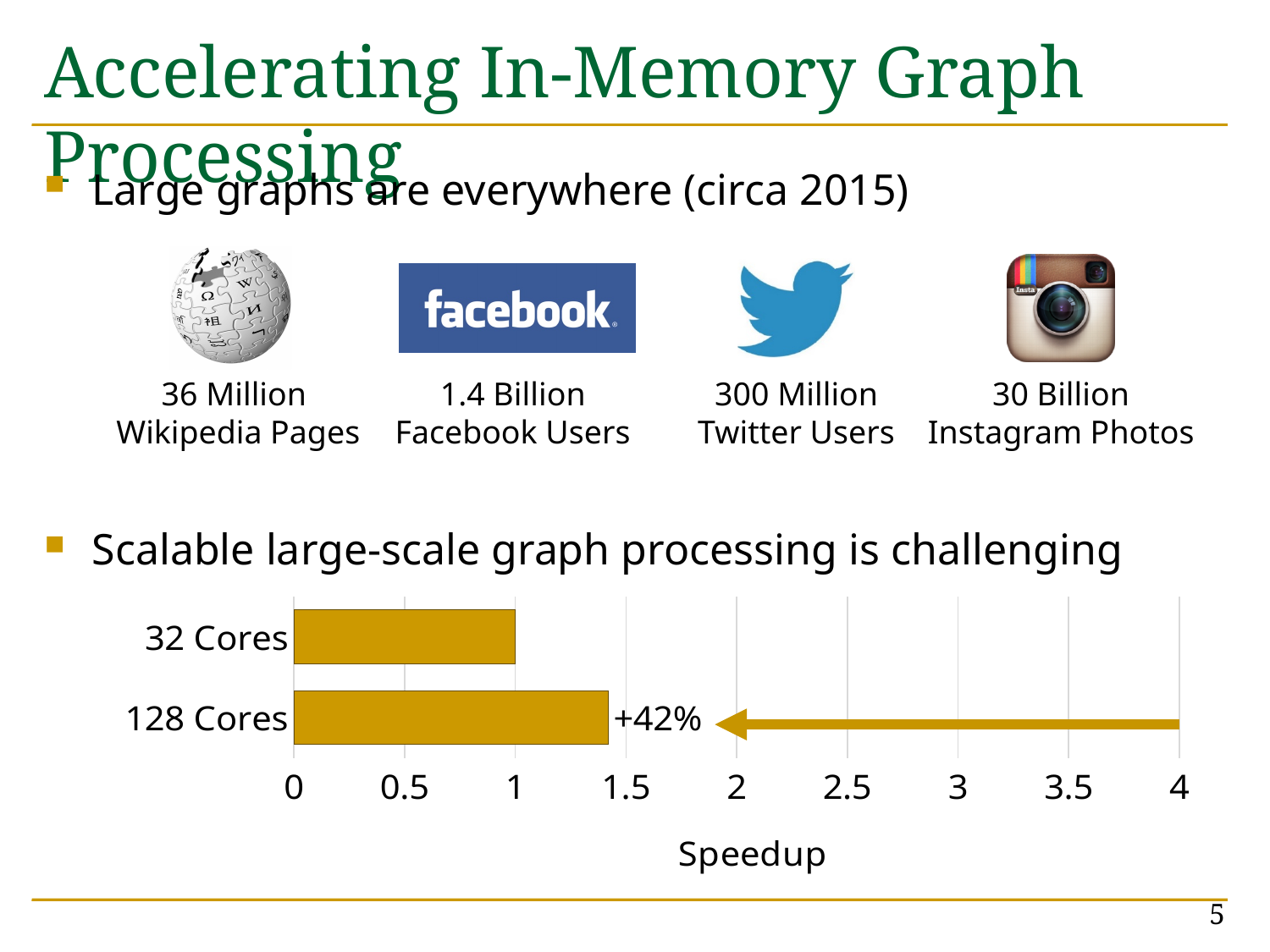
What type of chart is shown on the slide? bar chart What is the title of the x axis of the chart? Speedup Is the speedup for 128 Cores greater or less than 2? less What percentage improvement is annotated next to the 128 Cores bar? +42% Which category has the higher speedup, 32 Cores or 128 Cores? 128 Cores What is the maximum value shown on the x axis of the chart? 4 Which category has the highest speedup in the chart? 128 Cores What is the speedup value for 32 Cores? 1 Is the speedup for 128 Cores greater or less than 1? greater How many categories are plotted in the chart? 2 Which category has the lowest speedup in the chart? 32 Cores Is the speedup for 128 Cores greater or less than 1.5? less